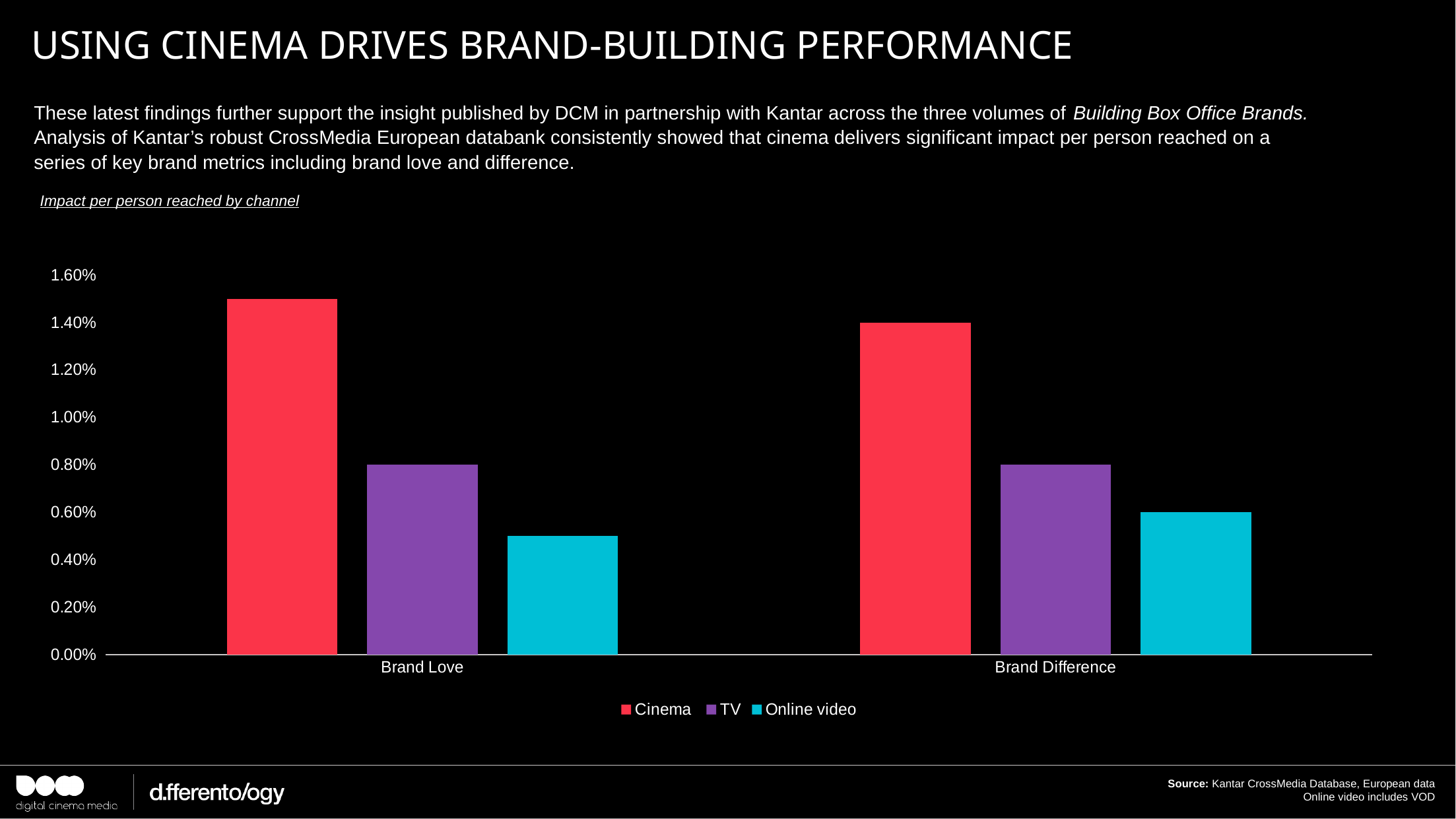
What is the value for TV in the Brand Love category? 0.80% Is the value for Cinema in the Brand Love category greater or less than 1.40%? greater How many categories are shown on the x axis? 2 What is the difference between the Cinema and TV values in the Brand Difference category? 0.60% How many series does the legend list? 3 What kind of chart is shown on the slide? bar chart Which is larger: the Online video value for Brand Love or the Online video value for Brand Difference? Brand Difference Which channel has the highest value in the Brand Love category? Cinema What is the value for Cinema in the Brand Difference category? 1.40% Is the value for Online video in the Brand Love category greater or less than 0.60%? less Which channel has the lowest value in the Brand Difference category? Online video What is the value for Online video in the Brand Difference category? 0.60%